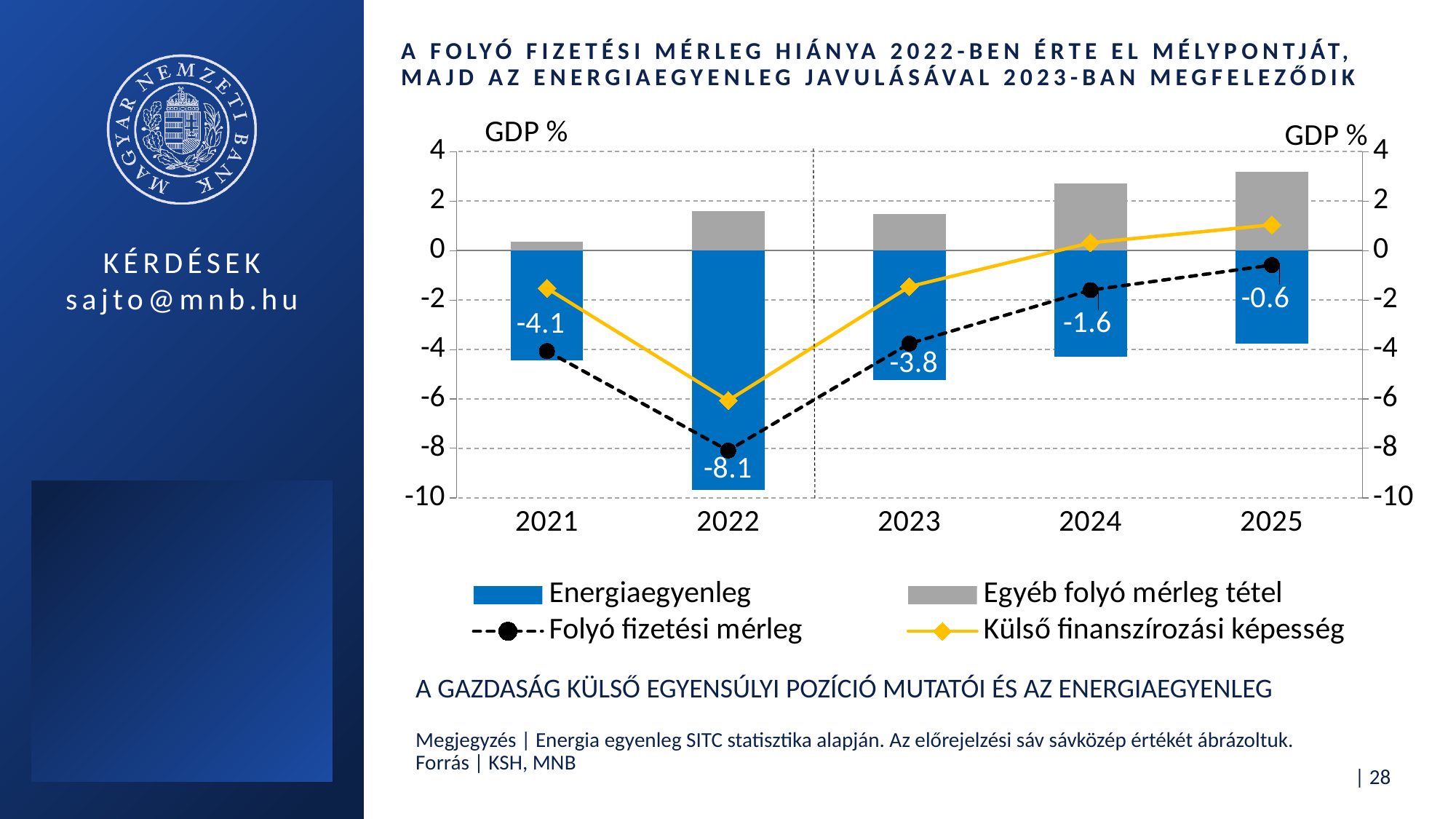
Is the value of Külső finanszírozási képesség in 2022 greater or less than -4? less How many years are shown on the x axis? 5 What is the value of Folyó fizetési mérleg in 2022? -8.1 Which year has the larger Folyó fizetési mérleg value, 2021 or 2024? 2024 What kind of chart is shown on the slide? Combined bar and line chart What is the difference between the Folyó fizetési mérleg values in 2023 and 2022? 4.3 In which year is the Folyó fizetési mérleg value the highest? 2025 In which year is the Folyó fizetési mérleg value the lowest? 2022 What is the value of Folyó fizetési mérleg in 2025? -0.6 Does the Folyó fizetési mérleg line rise or fall from 2022 to 2025? rise How many series does the legend list? 4 Is the Energiaegyenleg bar for 2022 greater or less than -8? less